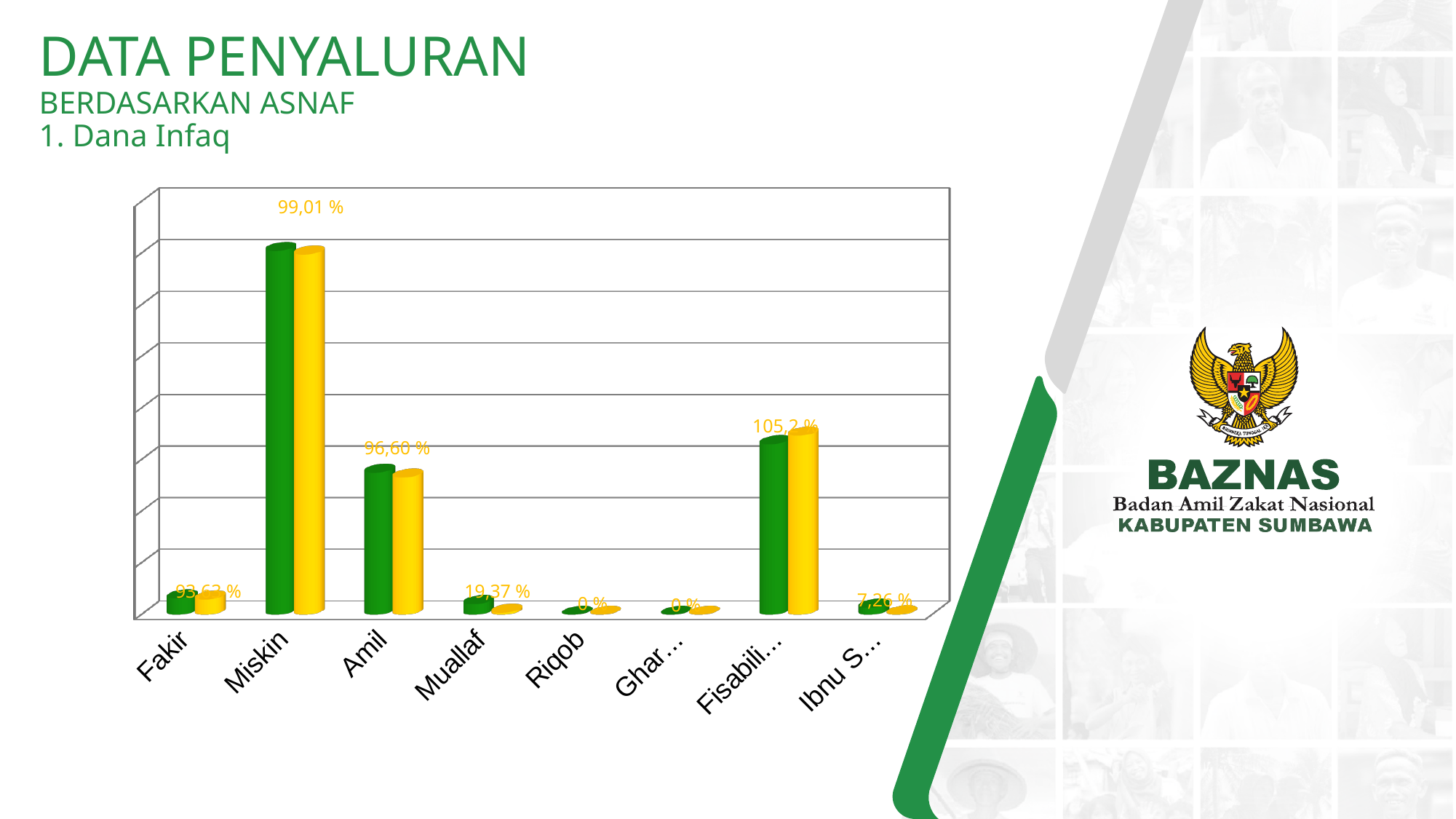
Which category has the tallest bars in the chart? Miskin Which has the larger labelled value, Miskin or Muallaf? Miskin What is the difference between the labelled values for Miskin and Amil? 2,41 % What is the data label shown for Amil? 96,60 % How many bars are plotted for each category in the chart? 2 What kind of chart is shown on the slide? bar chart What is the data label shown for Muallaf? 19,37 % How many categories are shown on the x axis of the chart? 8 What is the data label shown for Riqob? 0 % What is the data label shown for Fakir? 93,62 % What is the data label shown for Miskin? 99,01 % What two colours are used for the bars in the chart? green and yellow